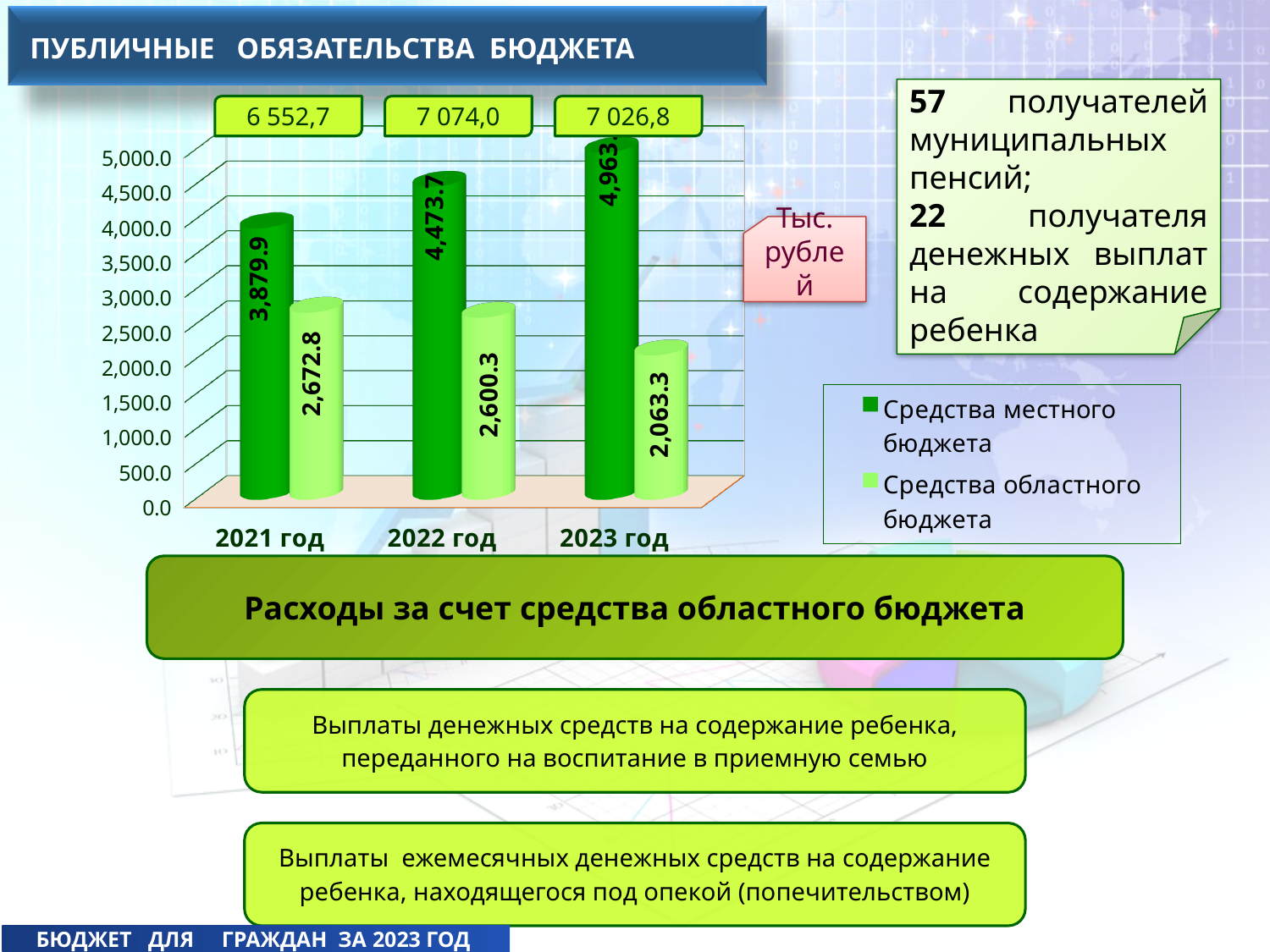
How many year categories are shown on the x axis of the chart? 3 How many series does the chart legend list? 2 Which year has the highest value for Средства местного бюджета? 2023 год What kind of chart is shown on the slide? bar chart Which year has the lowest value for Средства областного бюджета? 2023 год What is the difference between Средства местного бюджета and Средства областного бюджета in 2022 год? 1,873.4 What is the value for Средства областного бюджета in 2022 год? 2,600.3 Do the values for Средства областного бюджета rise or fall from 2021 год to 2023 год? fall What is the value for Средства местного бюджета in 2021 год? 3,879.9 What is the value for Средства местного бюджета in 2022 год? 4,473.7 What is the value for Средства областного бюджета in 2023 год? 2,063.3 Is the value for Средства местного бюджета in 2023 год greater or less than 4,500.0? greater